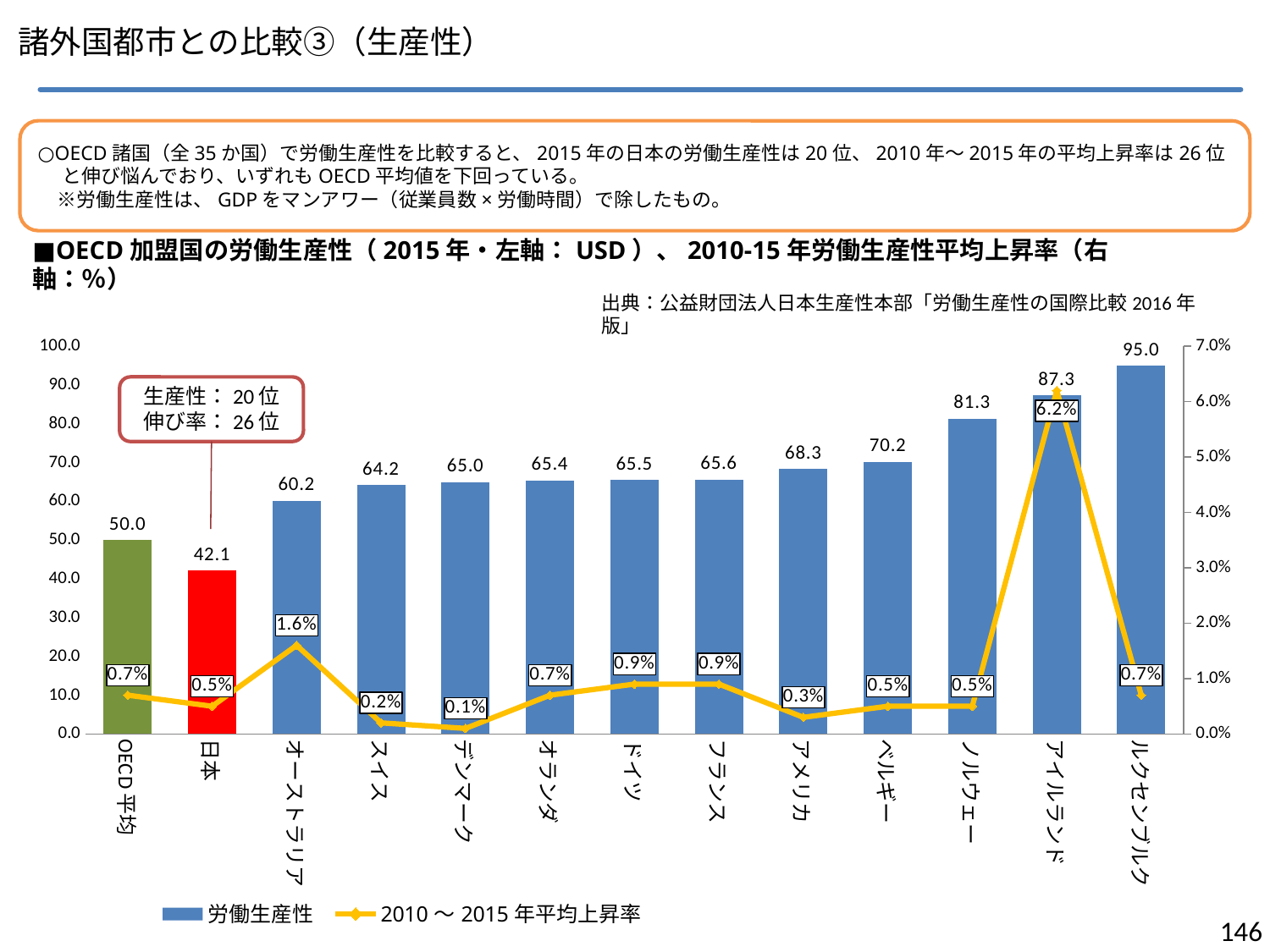
What kind of chart is shown on the slide? Combined bar and line chart How many series does the legend list? 2 What is the difference between the labour productivity of OECD平均 and 日本? 7.9 Which has a higher labour productivity value, アメリカ or ベルギー? ベルギー What is the labour productivity value shown for ルクセンブルク? 95.0 Which category has the highest 2010～2015年平均上昇率 value? アイルランド How many categories are shown on the x axis of the chart? 13 What is the 2010～2015年平均上昇率 value shown for デンマーク? 0.1% What is the 2010～2015年平均上昇率 value shown for アイルランド? 6.2% Which category has the highest labour productivity bar? ルクセンブルク Which category has the lowest labour productivity bar? 日本 What is the labour productivity (労働生産性) value shown for 日本? 42.1